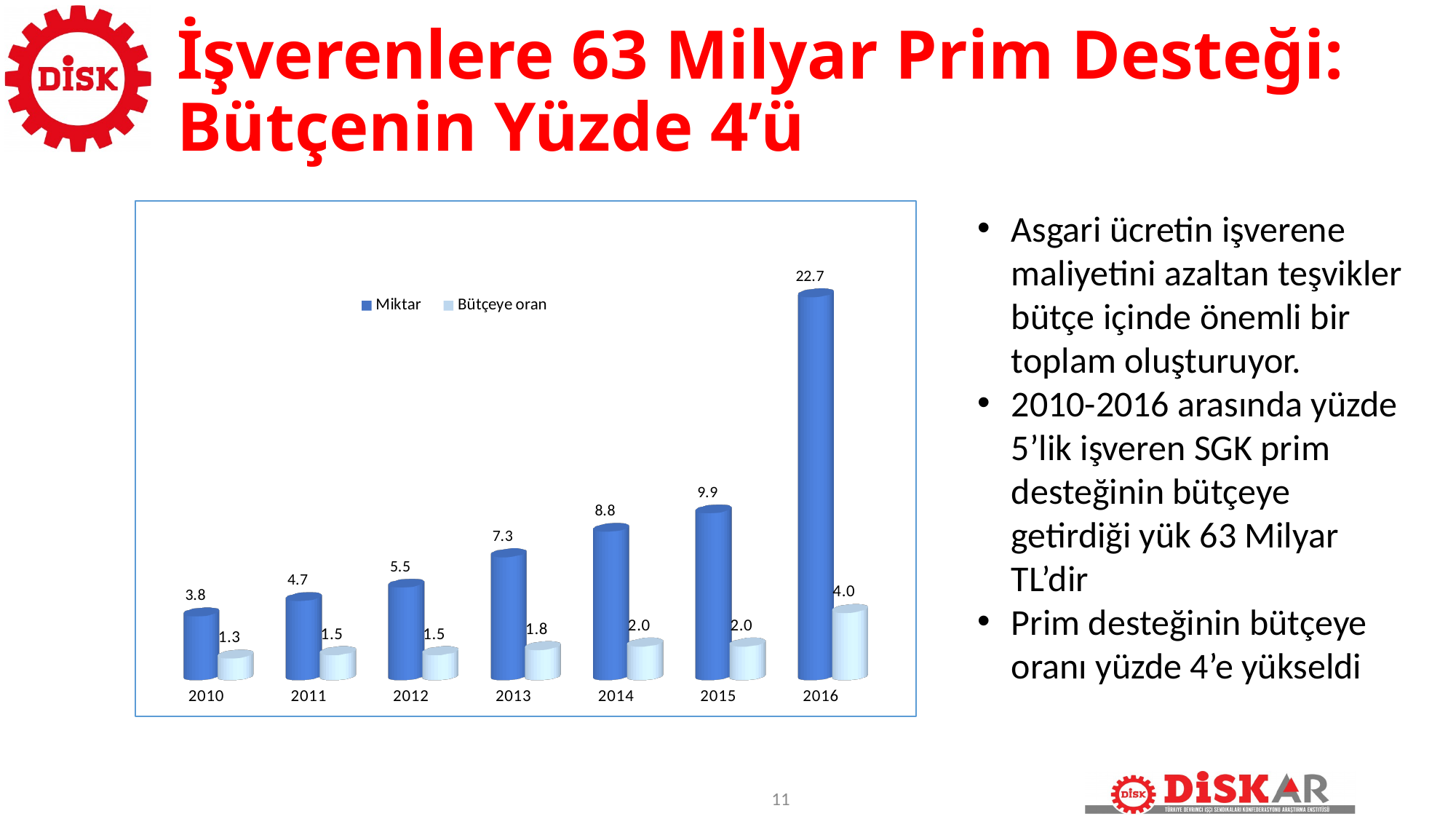
How many years are shown on the x axis? 7 How many series does the legend list? 2 Which is larger, the Miktar value for 2013 or for 2014? 2014 Which year has the lowest Bütçeye oran value? 2010 What are the two series named in the legend? Miktar and Bütçeye oran Do the Miktar values rise or fall from 2010 to 2016? rise What kind of chart is shown on the slide? bar chart Which year has the highest Miktar value? 2016 What is the Miktar value for 2016? 22.7 What is the difference between the Miktar values for 2016 and 2015? 12.8 What is the Miktar value for 2010? 3.8 What is the Bütçeye oran value for 2013? 1.8